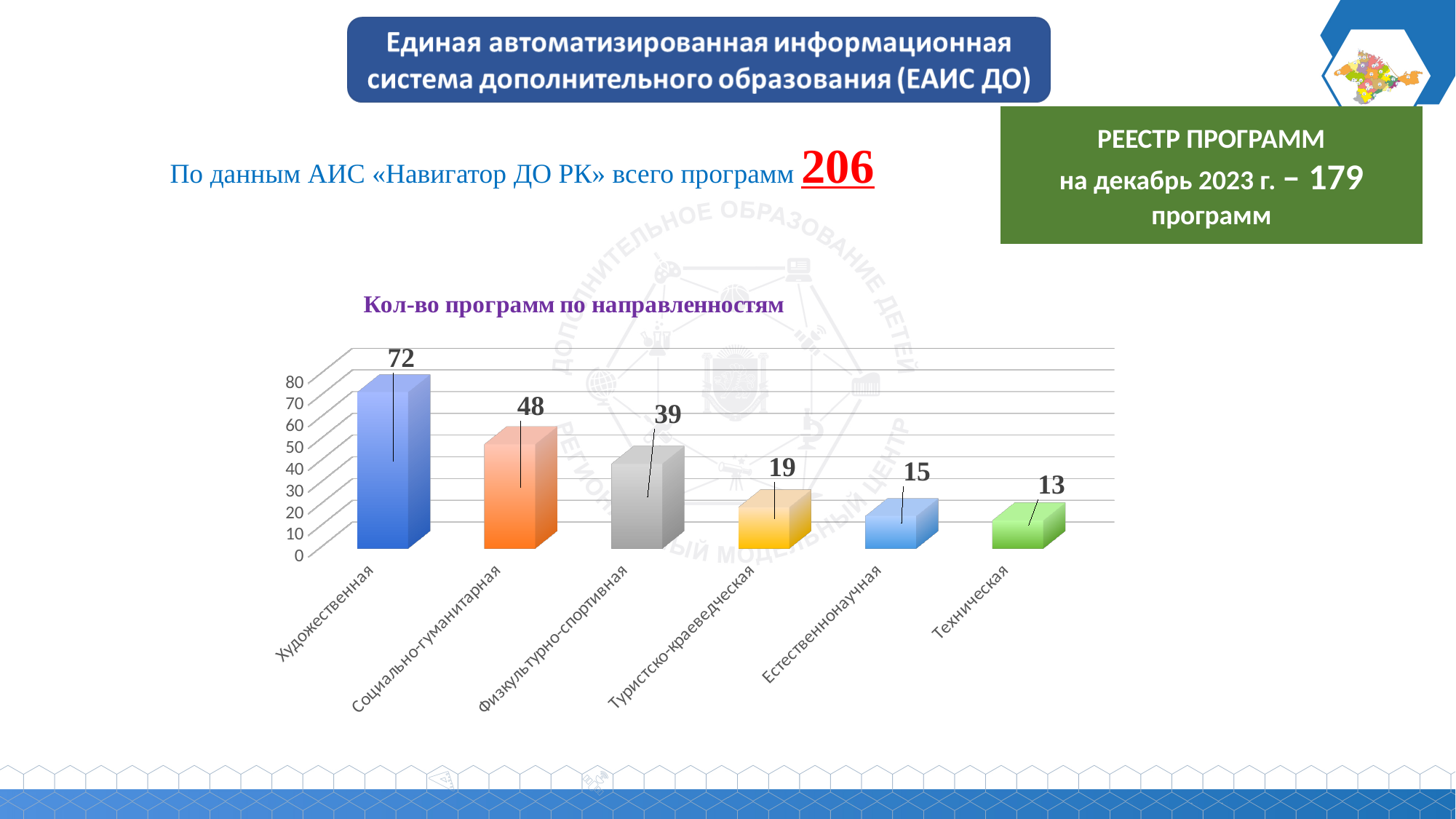
Which category has the lowest value? Техническая Do the values rise or fall from left to right along the x axis? Fall What is the difference between the values for Художественная and Социально-гуманитарная? 24 How many categories are shown in the chart? 6 Which category has the highest value? Художественная What kind of chart is shown on the slide? Bar chart What is the value for Физкультурно-спортивная? 39 Which is larger, the value for Туристско-краеведческая or Естественнонаучная? Туристско-краеведческая What is the title of the chart? Кол-во программ по направленностям What is the value for Художественная? 72 What is the value for Техническая? 13 What is the value for Социально-гуманитарная? 48